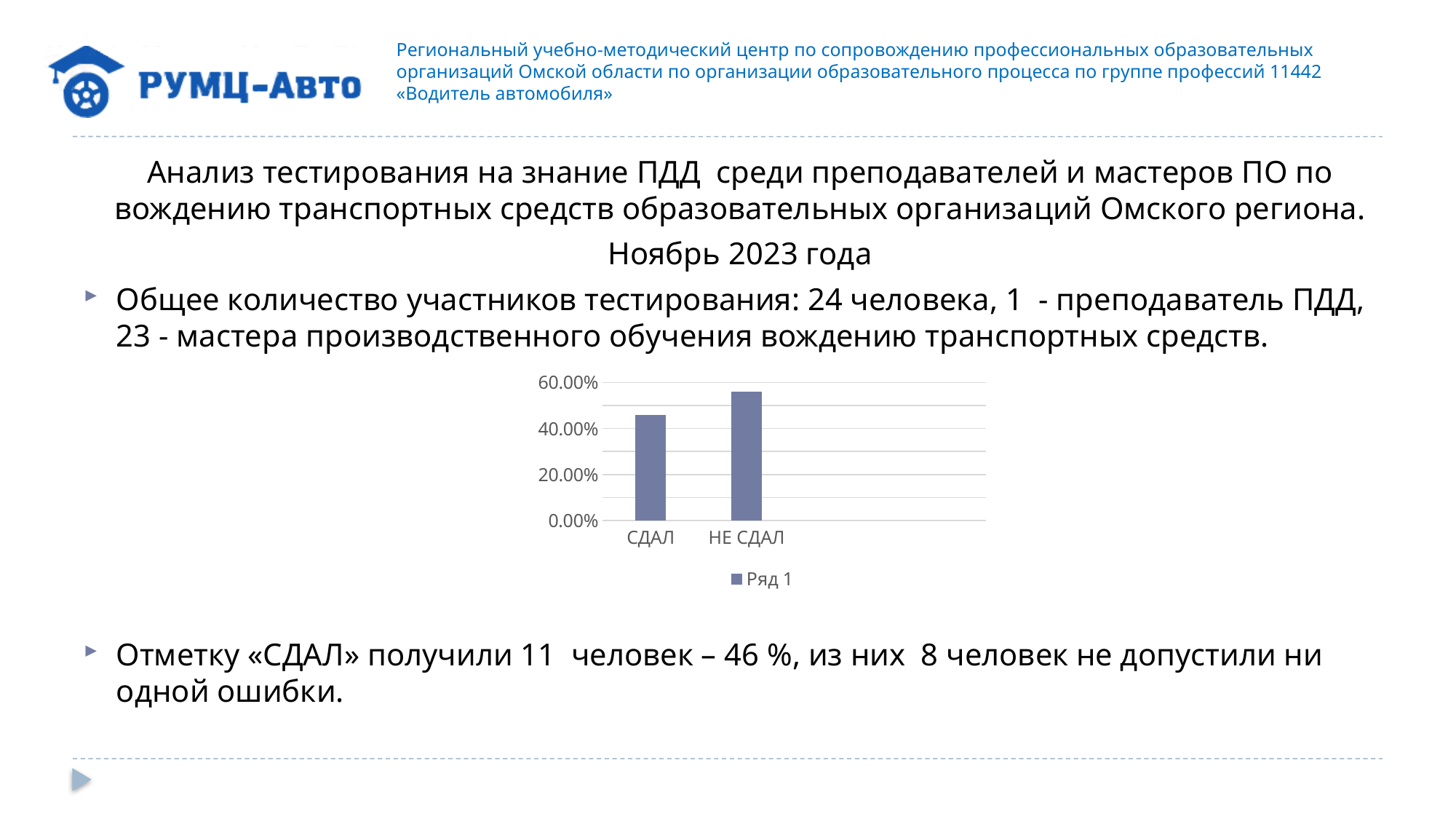
Is the value for СДАЛ greater or less than 60.00%? less Is the value for НЕ СДАЛ greater or less than 40.00%? greater How many series does the chart legend list? 1 Which bar is taller, СДАЛ or НЕ СДАЛ? НЕ СДАЛ What kind of chart is shown on the slide? bar chart What is the highest tick label shown on the chart's vertical axis? 60.00% Which category has the highest bar in the chart? НЕ СДАЛ What is the name of the series in the chart legend? Ряд 1 Which category has the lowest bar in the chart? СДАЛ Is the value for СДАЛ greater or less than 40.00%? greater How many categories are shown on the x axis of the chart? 2